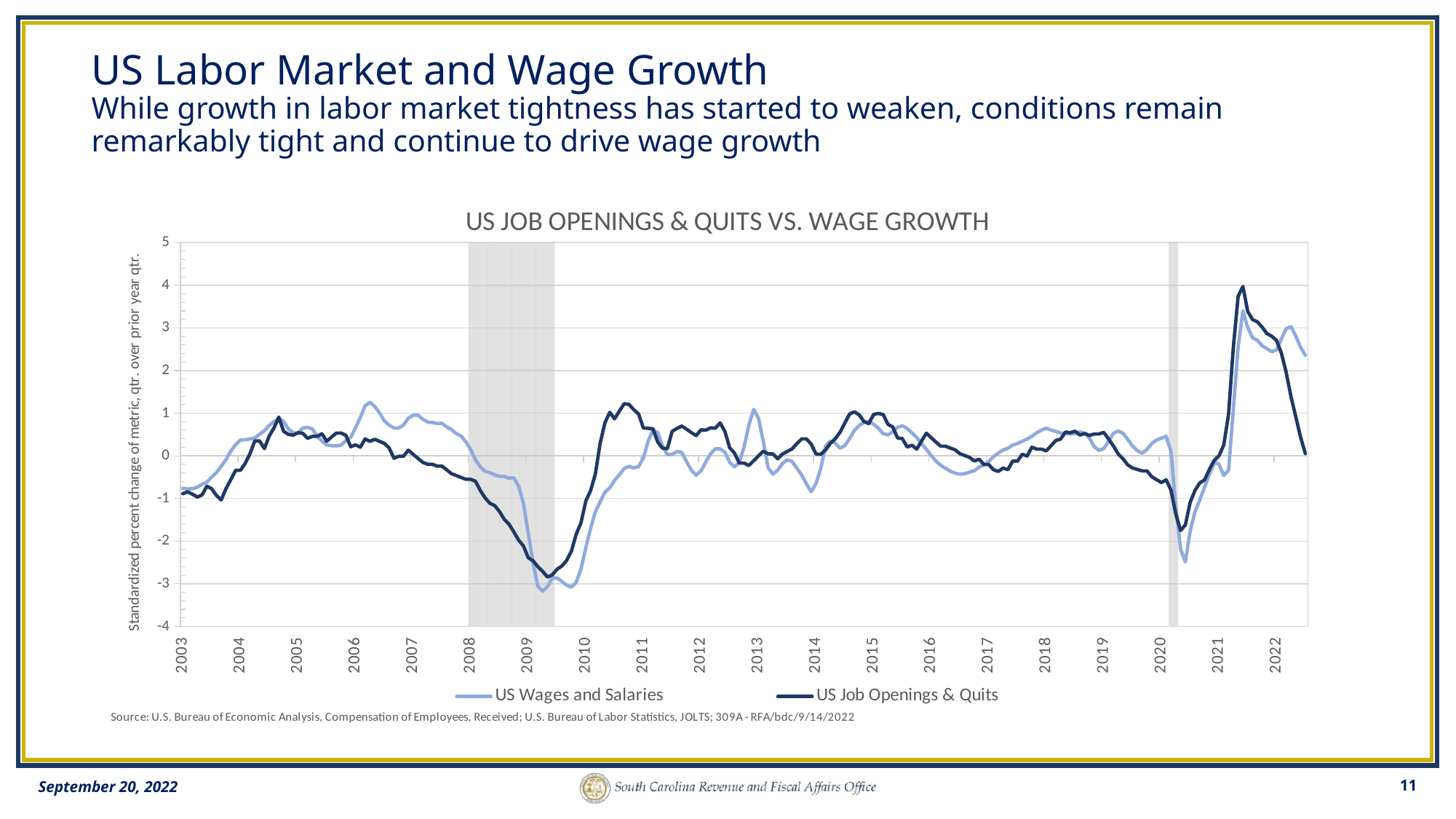
At the 2021 peak, which series reaches the higher value, US Wages and Salaries or US Job Openings & Quits? US Job Openings & Quits What kind of chart is shown on the slide? line chart Is the peak value of US Job Openings & Quits in 2021 greater or less than 3? greater What is the title of the chart? US JOB OPENINGS & QUITS VS. WAGE GROWTH Which series is drawn in the dark navy line? US Job Openings & Quits Is the lowest value of US Job Openings & Quits in 2020 greater or less than -1? less Is the lowest value of US Wages and Salaries in 2020 greater or less than -2? less At the 2020 trough, which series falls lower, US Wages and Salaries or US Job Openings & Quits? US Wages and Salaries How many series does the legend list? 2 How many year labels appear on the x axis? 20 Does the US Job Openings & Quits series rise or fall from its 2021 peak to the end of 2022? fall